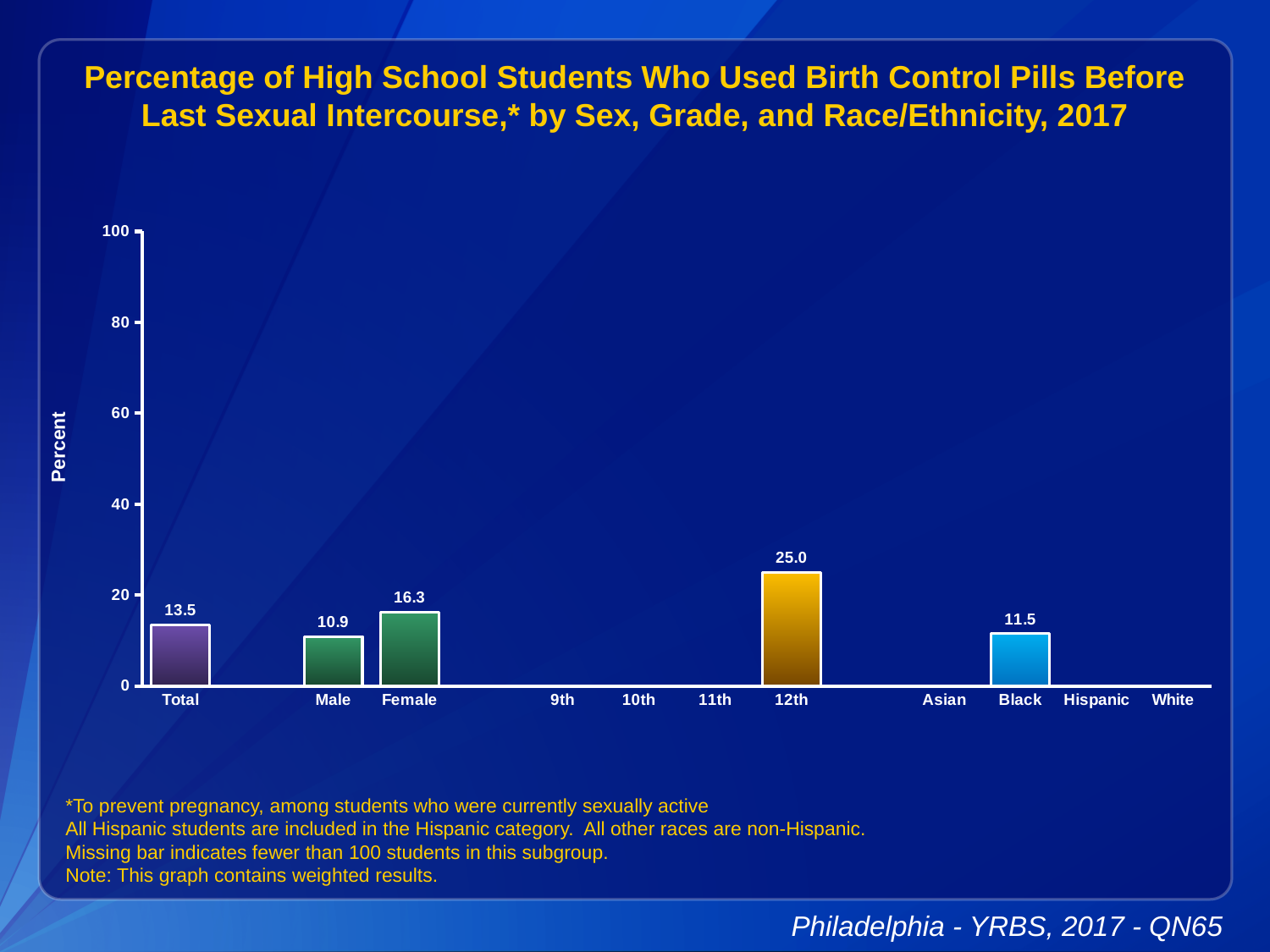
Is the value for 12th grade greater or less than 20? greater Which category with a plotted bar has the lowest value? Male What is the value for Total? 13.5 What is the difference between the Female and Male values? 5.4 Which is larger, the value for Total or the value for Black? Total What is the value for Black students? 11.5 What is the value for Female? 16.3 Which category has the highest value? 12th What is the label on the y axis? Percent What is the value for 12th grade? 25.0 How many categories have a bar plotted? 5 What kind of chart is shown? bar chart